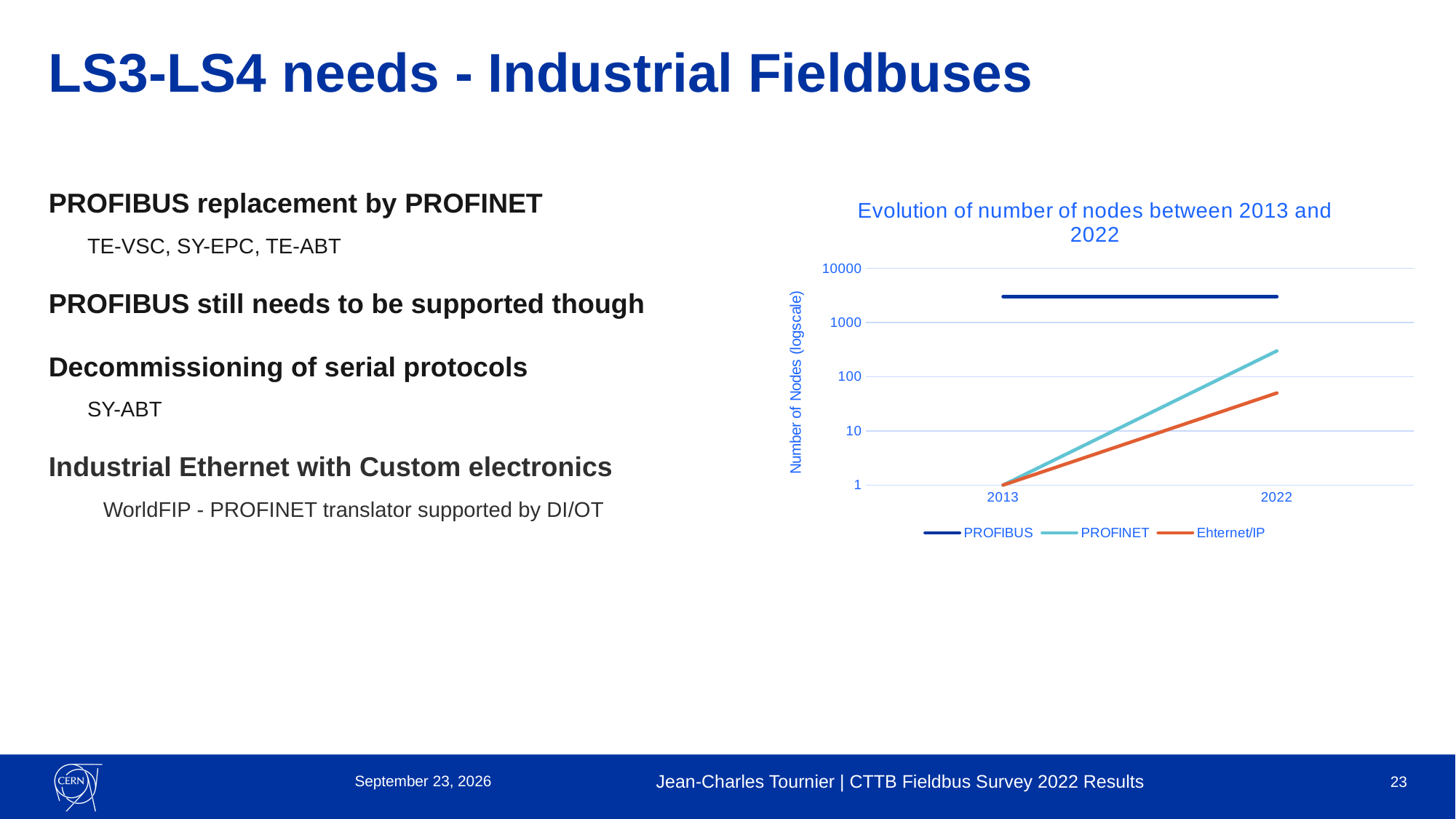
How many series does the chart legend list? 3 Which series has more nodes in 2022, PROFINET or Ehternet/IP? PROFINET Does the number of PROFINET nodes rise or fall from 2013 to 2022? rise How many years are shown on the x axis of the chart? 2 Is the value for Ehternet/IP in 2022 greater or less than 100? less What kind of chart is shown on the slide? line chart Which series has the lowest number of nodes in 2022? Ehternet/IP Which series has the highest number of nodes in 2022? PROFIBUS Is the value for PROFINET in 2022 greater or less than 100? greater What is the label of the chart's vertical axis? Number of Nodes (logscale) What is the title of the chart? Evolution of number of nodes between 2013 and 2022 Is the value for PROFIBUS in 2022 greater or less than 1000? greater